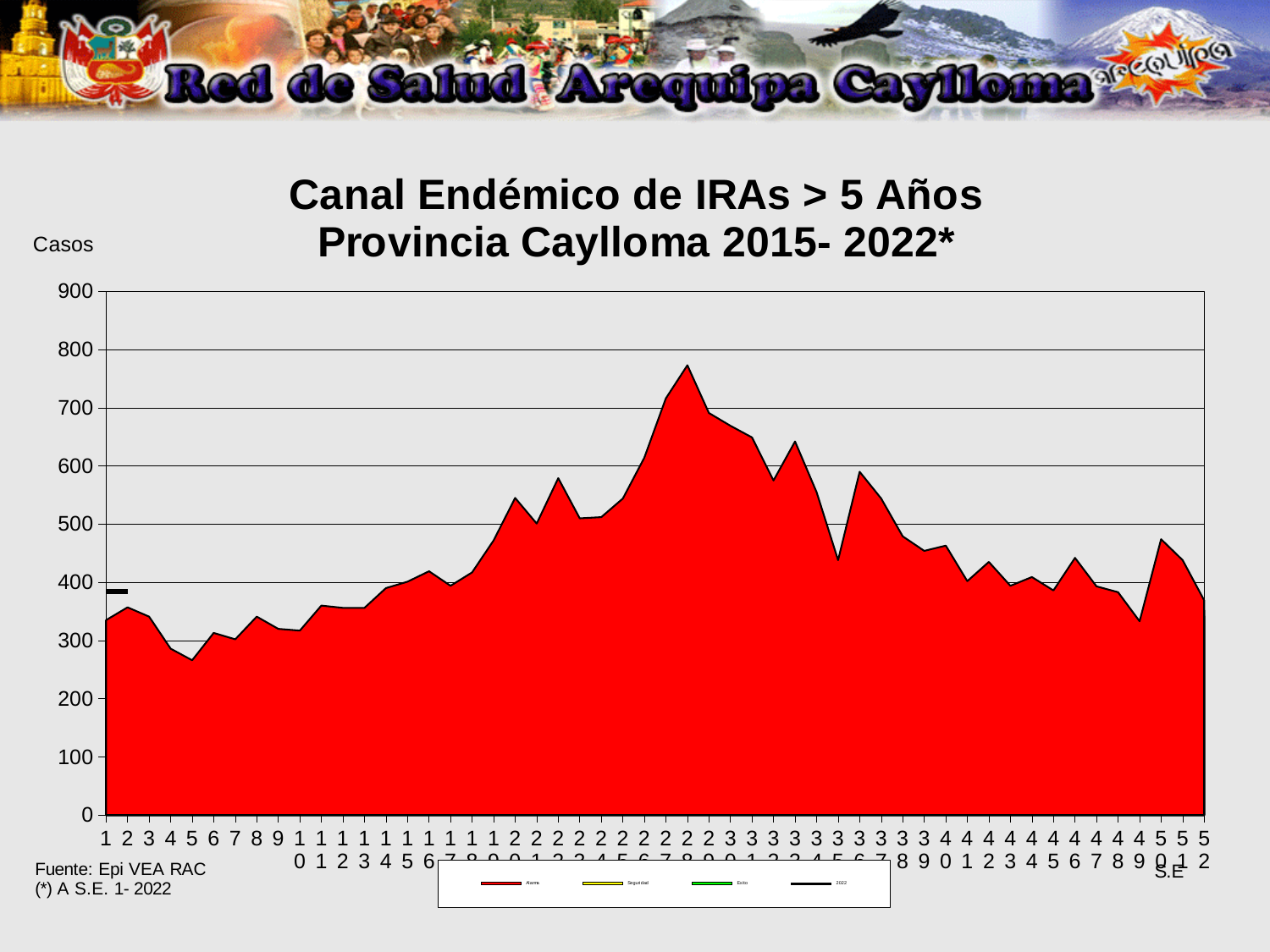
What is the title of the chart? Canal Endémico de IRAs > 5 Años Provincia Caylloma 2015- 2022* Is the value of the red area at week 5 greater or less than 300? less At which week does the red area reach its highest value? Week 28 What label is shown on the vertical axis of the chart? Casos What kind of chart is shown on the slide? Area chart Which week has a larger value in the red area, week 5 or week 50? Week 50 Is the value of the red area at week 52 greater or less than 400? less At which week does the red area reach its lowest value? Week 5 Is the value of the red area at week 28 greater or less than 700? greater Do the values of the red area generally rise or fall from week 28 to week 52? Fall Which week has a larger value in the red area, week 28 or week 37? Week 28 How many epidemiological weeks (S.E.) are shown along the x axis? 52